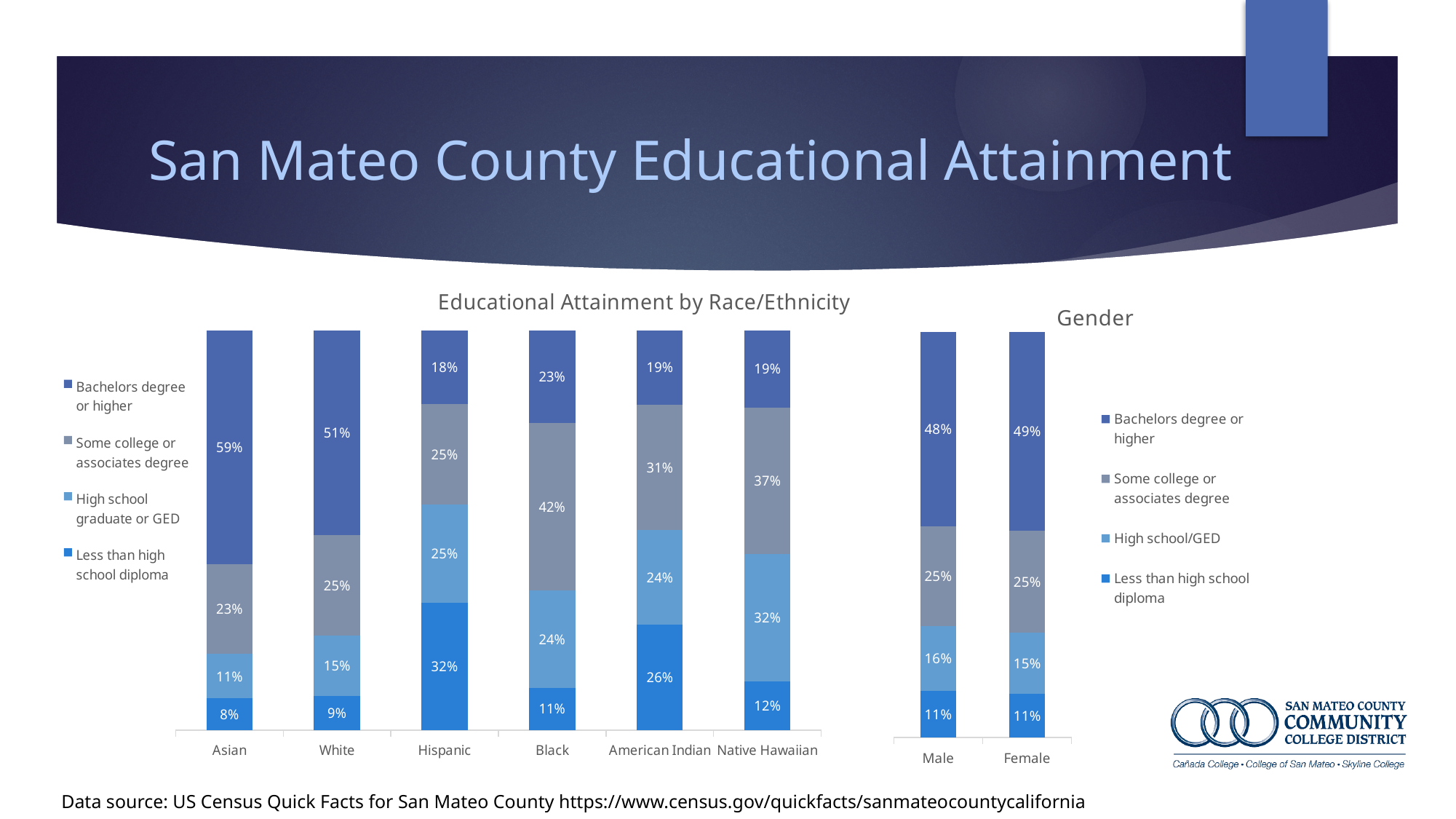
How many race/ethnicity categories are shown in the Educational Attainment by Race/Ethnicity chart? 6 In the Gender chart, what is the total of the Male stacked bar? 100% In the Gender chart, what percentage of females have a bachelors degree or higher? 49% In the Gender chart, what is the difference between the High school/GED share for Male and Female? 1% In the Educational Attainment by Race/Ethnicity chart, what is the value for Hispanic residents with less than a high school diploma? 32% In the Educational Attainment by Race/Ethnicity chart, which is larger: the some college or associates degree share for Black residents or for Native Hawaiian residents? Black What kind of chart is the Gender chart? Stacked bar chart In the Educational Attainment by Race/Ethnicity chart, which race/ethnicity has the highest share with a bachelors degree or higher? Asian In the Educational Attainment by Race/Ethnicity chart, which race/ethnicity has the lowest share with less than a high school diploma? Asian How many series does the legend of the Educational Attainment by Race/Ethnicity chart list? 4 In the Educational Attainment by Race/Ethnicity chart, what is the difference between the bachelors degree or higher share for White and for Black residents? 28% In the Educational Attainment by Race/Ethnicity chart, what percentage of Asian residents have a bachelors degree or higher? 59%